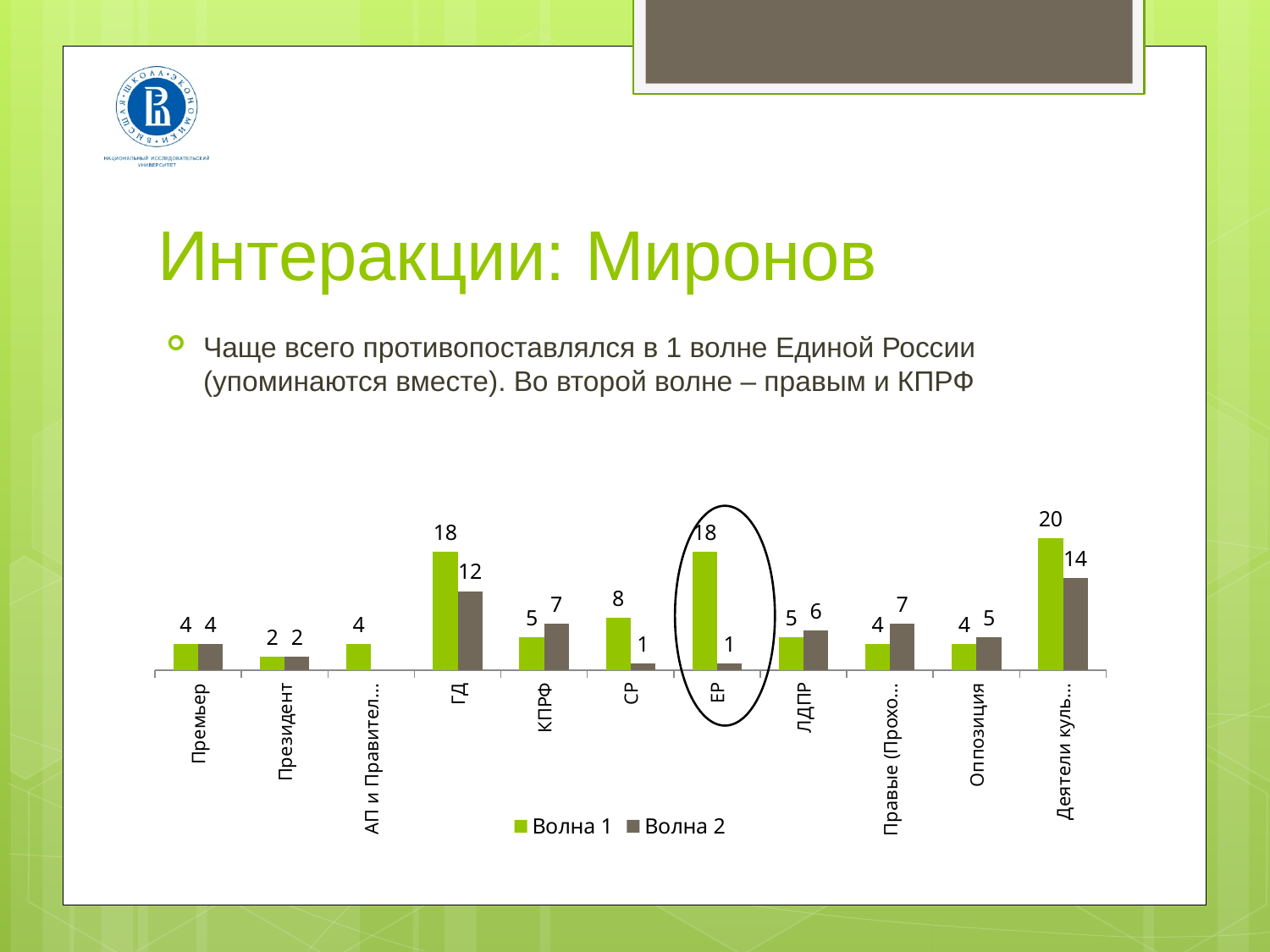
Which category on the chart is circled? ЕР What is the value of Волна 1 for СР? 8 What type of chart is shown on the slide? bar chart What is the value of Волна 2 for КПРФ? 7 How many categories are shown on the x axis of the chart? 11 What is the value of Волна 1 for ГД? 18 Which category has the lowest Волна 1 value? Президент What is the value of Волна 2 for ЕР? 1 How many series does the legend list? 2 Which is larger for ЛДПР, Волна 1 or Волна 2? Волна 2 Which category has the highest Волна 1 value? Деятели куль... What is the difference between Волна 1 and Волна 2 for ЕР? 17